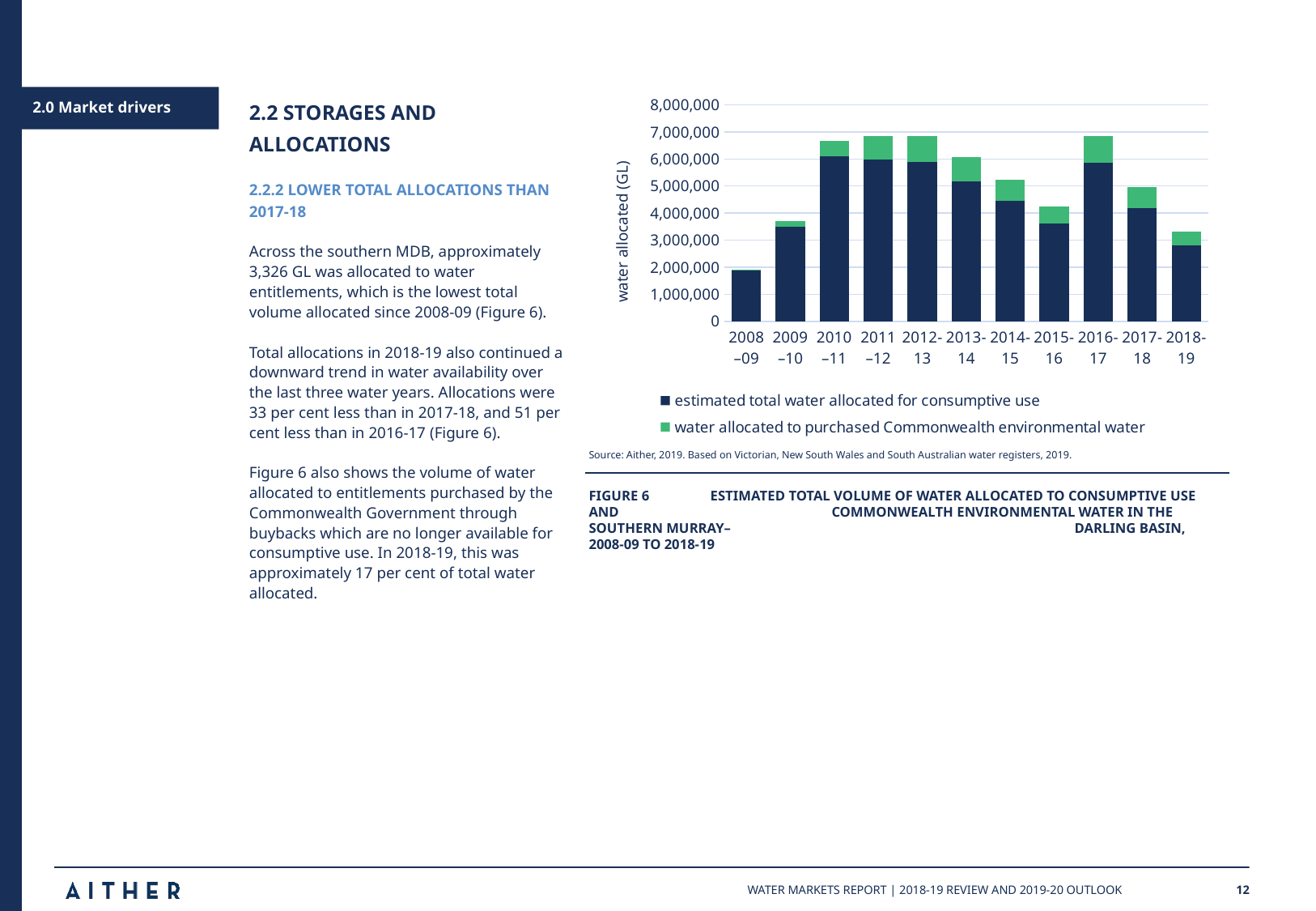
Do the total bars rise or fall from 2012–13 to 2015–16? fall What is the label on the chart's vertical axis? water allocated (GL) Is the total bar for 2010–11 greater or less than 6,000,000? greater Which has the larger total bar, 2008–09 or 2018–19? 2018–19 Is the total bar for 2008–09 greater or less than 2,000,000? less Is the total bar for 2009–10 greater or less than 4,000,000? less Which water year has the lowest total bar in the chart? 2008–09 What kind of chart is shown on the slide? bar chart Which has the larger total bar, 2014–15 or 2015–16? 2014–15 How many water years are shown along the x axis of the chart? 11 How many series does the chart's legend list? 2